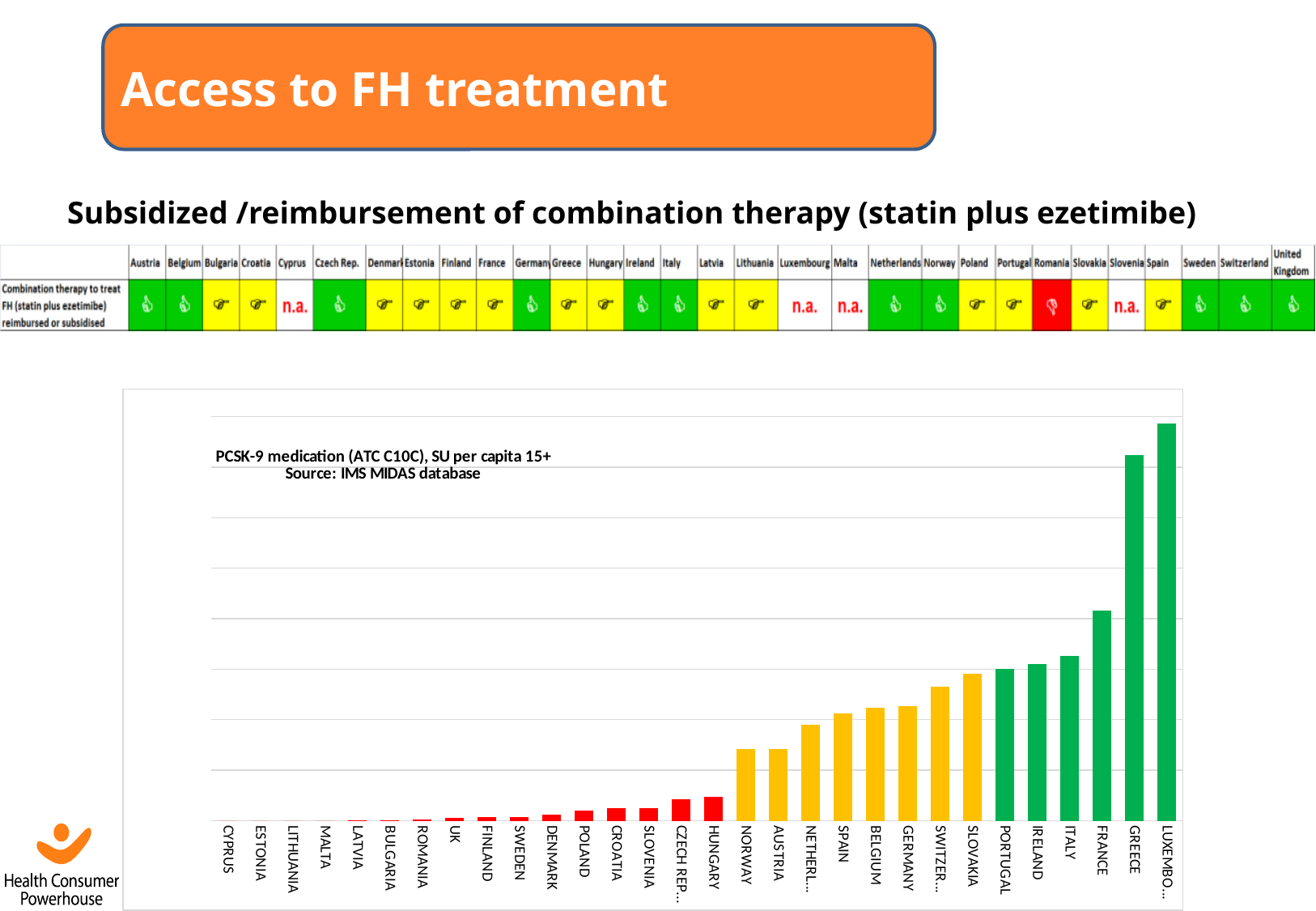
In the PCSK-9 medication chart, which is larger, the value for Greece or the value for France? Greece In the PCSK-9 medication chart, which is larger, the value for Hungary or the value for Norway? Norway What source is cited for the bar chart on the slide? IMS MIDAS database Do the bar values rise or fall from left to right in the PCSK-9 medication chart? rise In the PCSK-9 medication chart, which is larger, the value for Norway or the value for Spain? Spain What kind of chart is shown on the slide? bar chart What is the title of the bar chart on the slide? PCSK-9 medication (ATC C10C), SU per capita 15+ Which country has the highest value in the PCSK-9 medication chart? Luxembourg Which country has the second-highest bar in the PCSK-9 medication chart? Greece How many bars in the PCSK-9 medication chart are coloured green? 6 How many countries are plotted in the PCSK-9 medication chart? 30